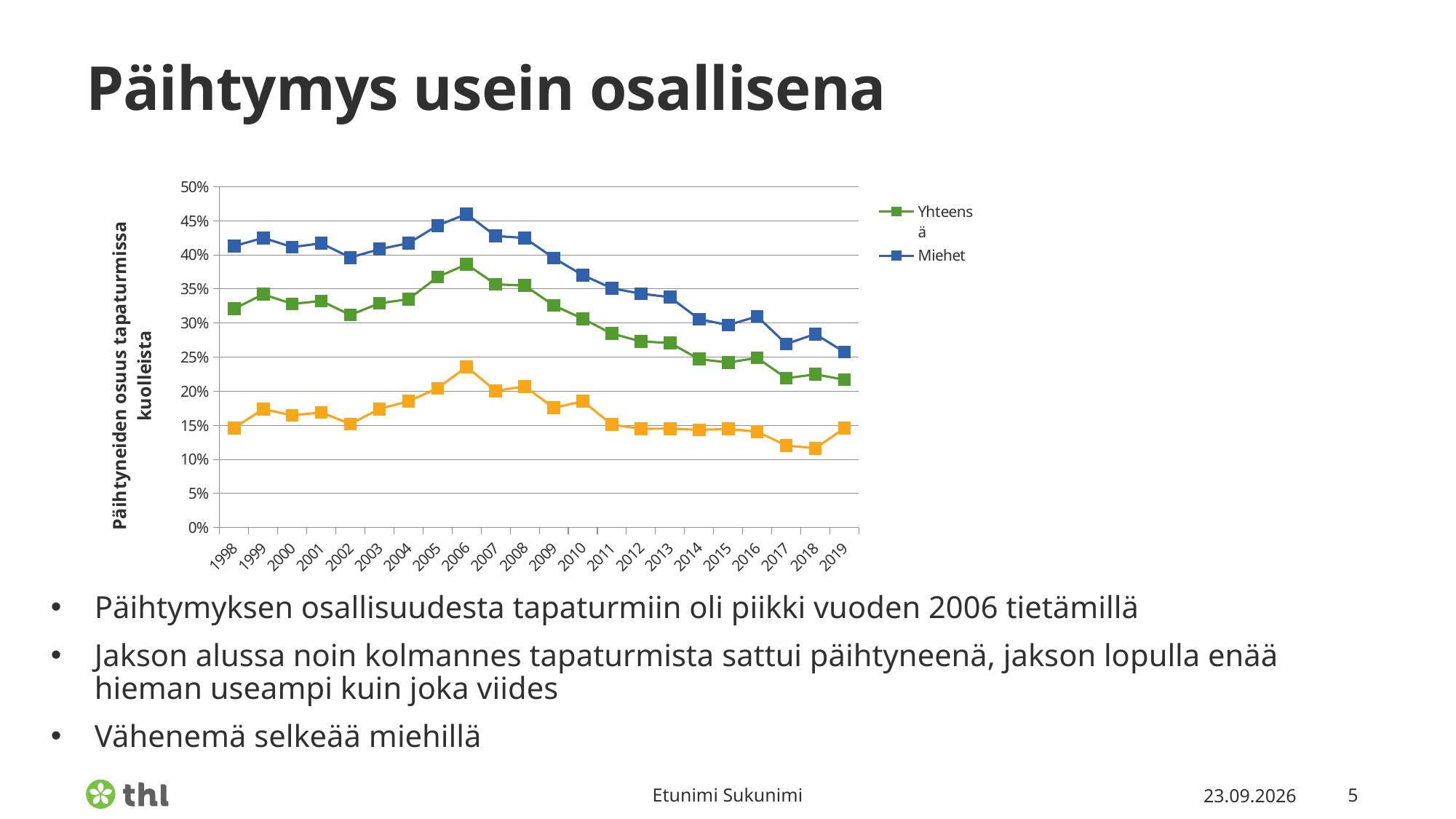
Which series has the larger value in 2006, Miehet or Yhteensä? Miehet What is the title of the vertical axis of the chart? Päihtyneiden osuus tapaturmissa kuolleista Is the value for Yhteensä in 2019 greater or less than 25%? less Is the value for Miehet in 2019 greater or less than 30%? less How many years are shown on the x axis of the chart? 22 Does the Miehet series rise or fall overall from 2006 to 2019? fall What kind of chart is shown on the slide? line chart In which year is the Miehet series at its lowest value? 2019 In which year does the Miehet series reach its highest value? 2006 How many series does the chart legend list? 2 Is the value for Miehet in 1998 greater or less than 40%? greater In which year does the Yhteensä series reach its highest value? 2006